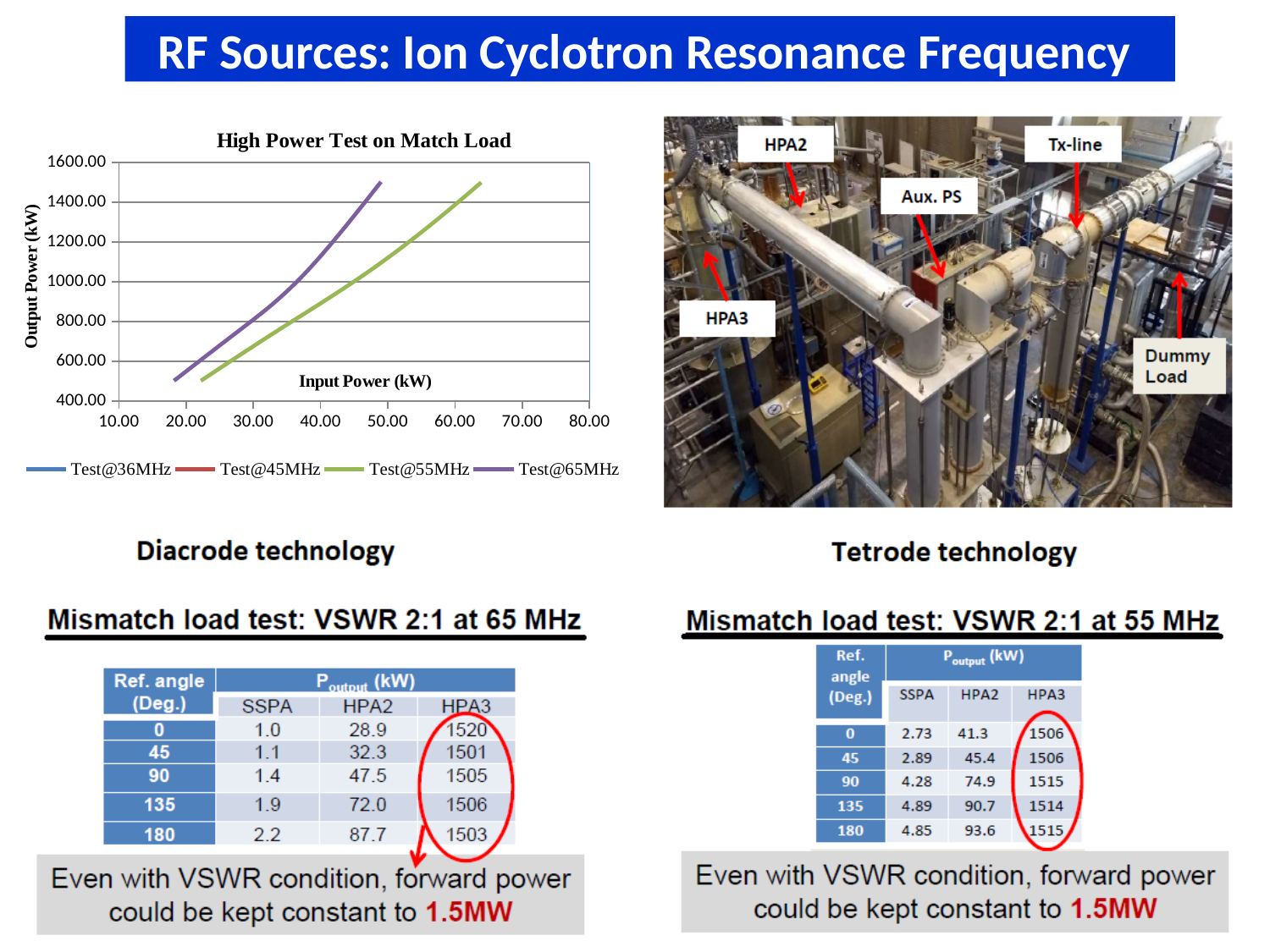
In the 'High Power Test on Match Load' chart, is the output power for Test@55MHz at an input power of 30.00 kW greater or less than 800.00? less In the 'High Power Test on Match Load' chart, does the output power for Test@65MHz rise or fall as input power increases? rise In the 'High Power Test on Match Load' chart, does the output power for Test@55MHz rise or fall as input power increases? rise What is the y-axis label of the 'High Power Test on Match Load' chart? Output Power (kW) In the 'High Power Test on Match Load' chart, at an input power of 40.00 kW, which series has the higher output power: Test@55MHz or Test@65MHz? Test@65MHz In the 'High Power Test on Match Load' chart, which series reaches an output power of 1400.00 kW at a lower input power: Test@55MHz or Test@65MHz? Test@65MHz In the 'High Power Test on Match Load' chart, is the output power for Test@55MHz at an input power of 60.00 kW greater or less than 1200.00? greater What is the title of the chart on the left of the slide? High Power Test on Match Load What kind of chart is the 'High Power Test on Match Load' chart? line chart In the 'High Power Test on Match Load' chart, is the output power for Test@65MHz at an input power of 40.00 kW greater or less than 1000.00? greater How many series does the legend of the 'High Power Test on Match Load' chart list? 4